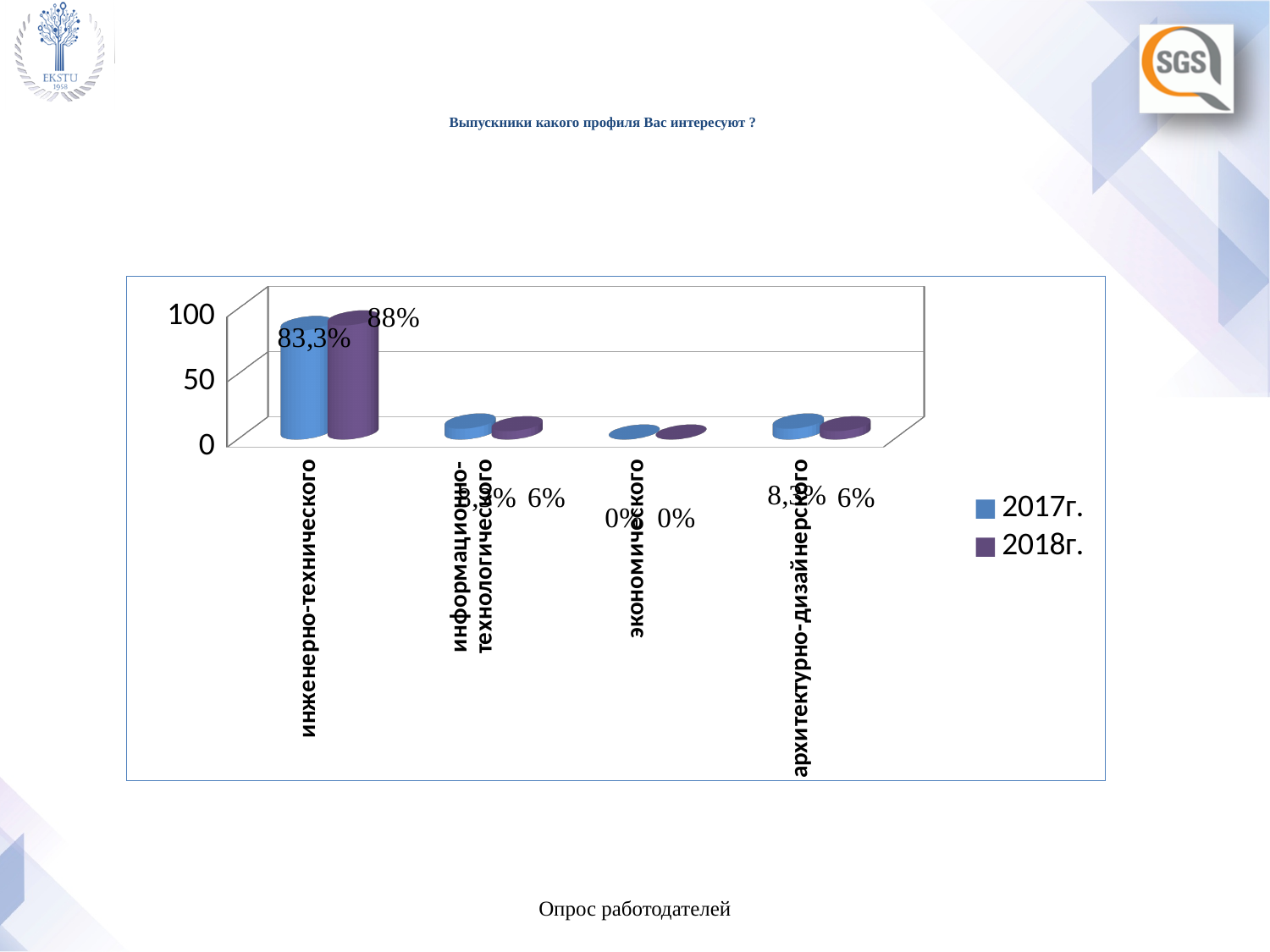
How many series does the legend list? 2 What is the value for экономического in the 2017г. series? 0% What is the value for архитектурно-дизайнерского in the 2018г. series? 6% What kind of chart is shown on the slide? bar chart Which category has the lowest value in the 2017г. series? экономического Which is larger for инженерно-технического: the 2017г. value or the 2018г. value? 2018г. What is the value for инженерно-технического in the 2017г. series? 83,3% Is the 2018г. value for инженерно-технического greater or less than 50? greater How many categories are shown on the x axis? 4 Which category has the highest value in the 2018г. series? инженерно-технического What is the value for информационно-технологического in the 2018г. series? 6% What is the value for инженерно-технического in the 2018г. series? 88%